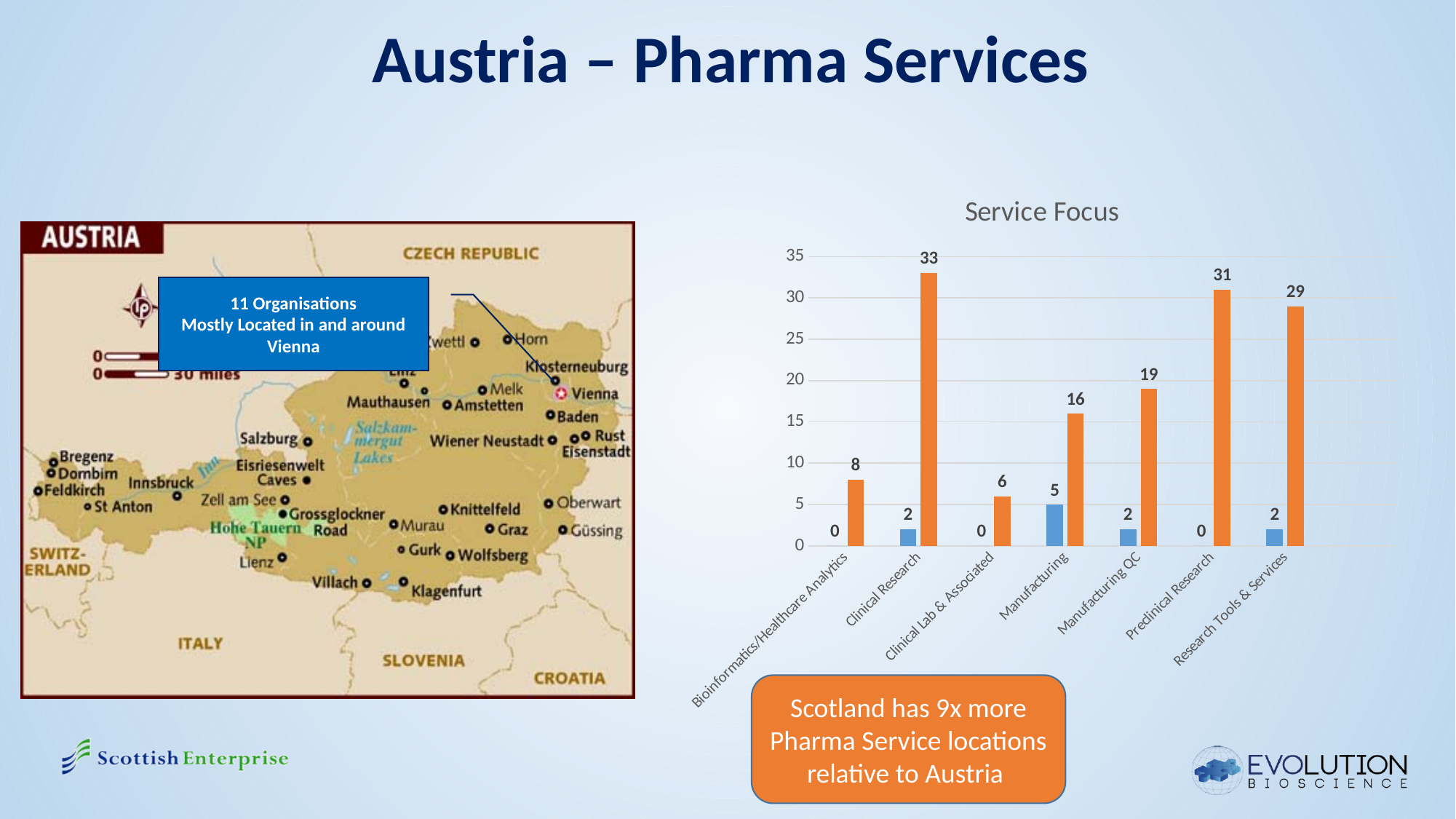
What is the title of the chart? Service Focus What is the value of the orange bar for Clinical Research? 33 How many categories are shown on the x axis of the chart? 7 Which category has the lowest orange bar? Clinical Lab & Associated Which category has the highest orange bar? Clinical Research Which is larger, the orange bar for Manufacturing or the orange bar for Manufacturing QC? Manufacturing QC What is the difference between the orange bars for Preclinical Research and Research Tools & Services? 2 Which category has the highest blue bar? Manufacturing What type of chart is shown on the slide? bar chart What is the value of the blue bar for Manufacturing? 5 What is the value of the orange bar for Manufacturing QC? 19 How many categories have a blue bar value of 0? 3